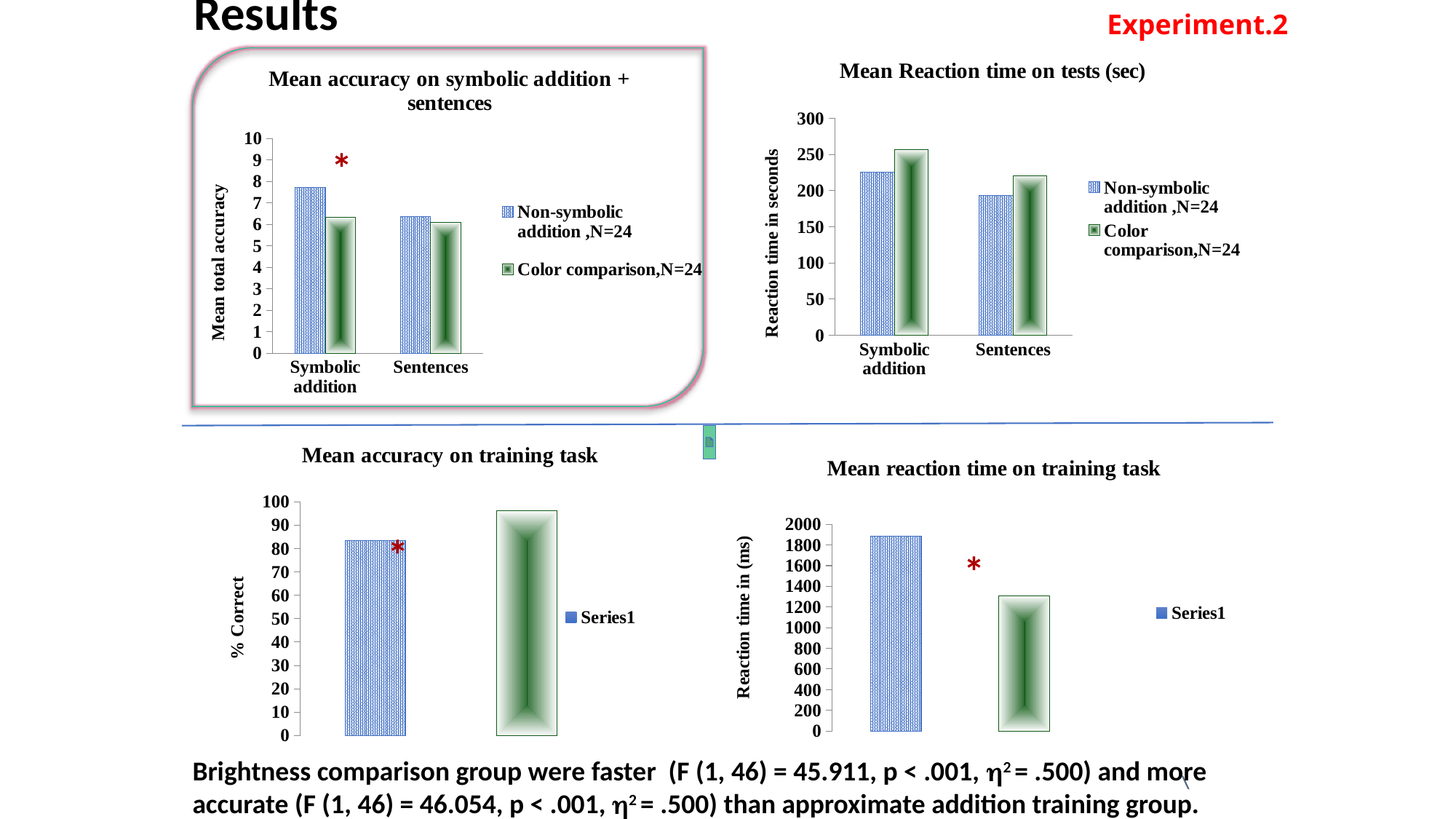
In the 'Mean accuracy on symbolic addition + sentences' chart, which series has the higher value for Symbolic addition, Non-symbolic addition or Color comparison? Non-symbolic addition ,N=24 In the 'Mean Reaction time on tests (sec)' chart, is the Non-symbolic addition value for Sentences greater or less than 200? less In the 'Mean reaction time on training task' chart, is the value of the blue bar greater or less than 1800? greater In the 'Mean accuracy on symbolic addition + sentences' chart, how many series does the legend list? 2 In the 'Mean accuracy on symbolic addition + sentences' chart, is the Non-symbolic addition value for Symbolic addition greater or less than 7? greater In the 'Mean accuracy on training task' chart, which bar is taller, the blue bar or the green bar? the green bar In the 'Mean accuracy on symbolic addition + sentences' chart, how many categories are shown on the x axis? 2 What type of chart is 'Mean reaction time on training task'? bar chart In the 'Mean Reaction time on tests (sec)' chart, which series has the higher value for Sentences, Non-symbolic addition or Color comparison? Color comparison,N=24 In the 'Mean Reaction time on tests (sec)' chart, what is the label of the y axis? Reaction time in seconds